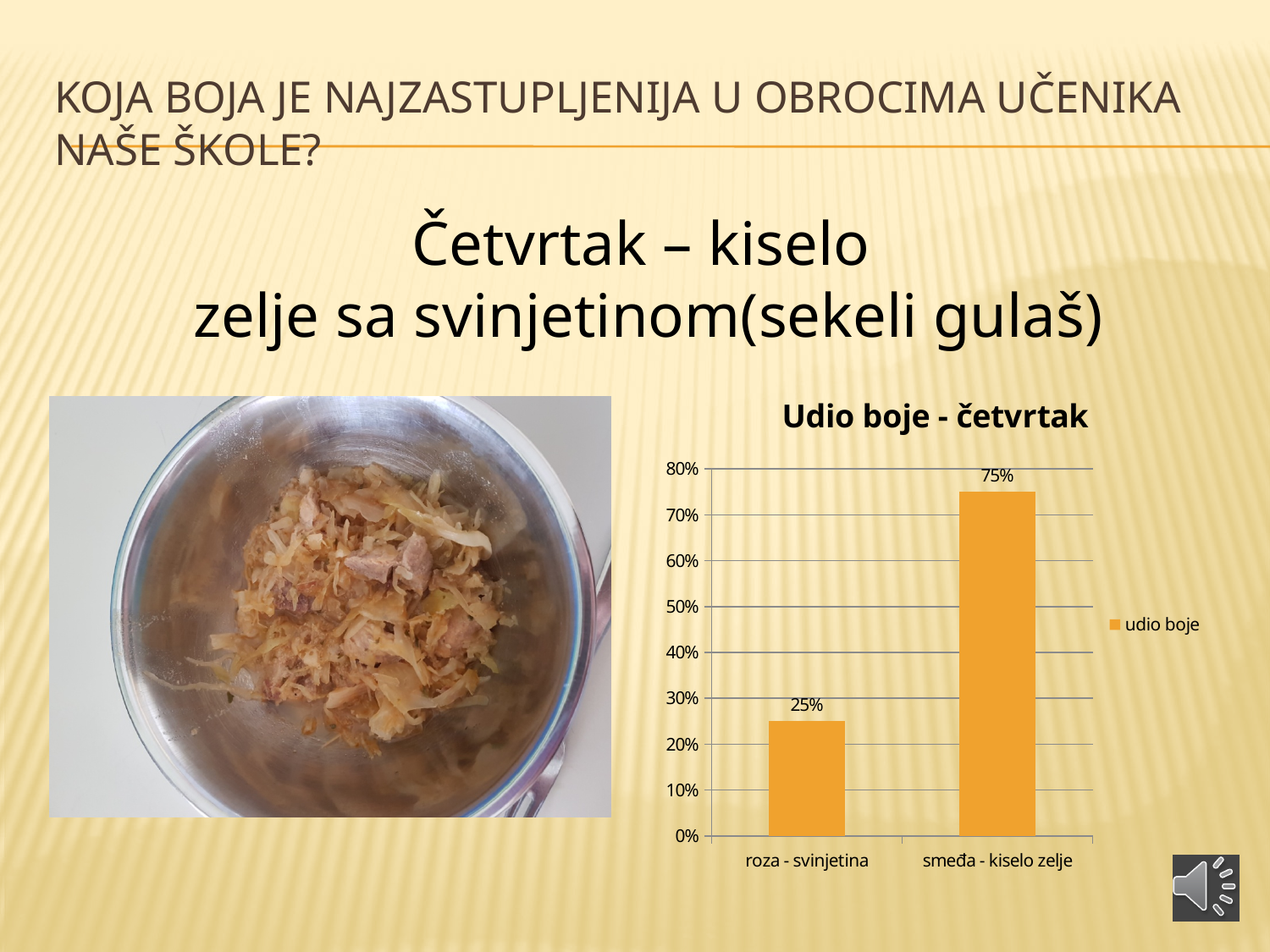
Which category has the highest value? smeđa - kiselo zelje How many categories are shown on the x axis? 2 What is the title of the chart? Udio boje - četvrtak How many series does the legend list? 1 Is the value for roza - svinjetina greater or less than 30%? less Which category has the lowest value? roza - svinjetina What is the difference between the values for smeđa - kiselo zelje and roza - svinjetina? 50% What is the value for roza - svinjetina? 25% What is the value for smeđa - kiselo zelje? 75% What kind of chart is shown on the slide? bar chart Which is larger, the value for roza - svinjetina or the value for smeđa - kiselo zelje? smeđa - kiselo zelje Is the value for smeđa - kiselo zelje greater or less than 50%? greater